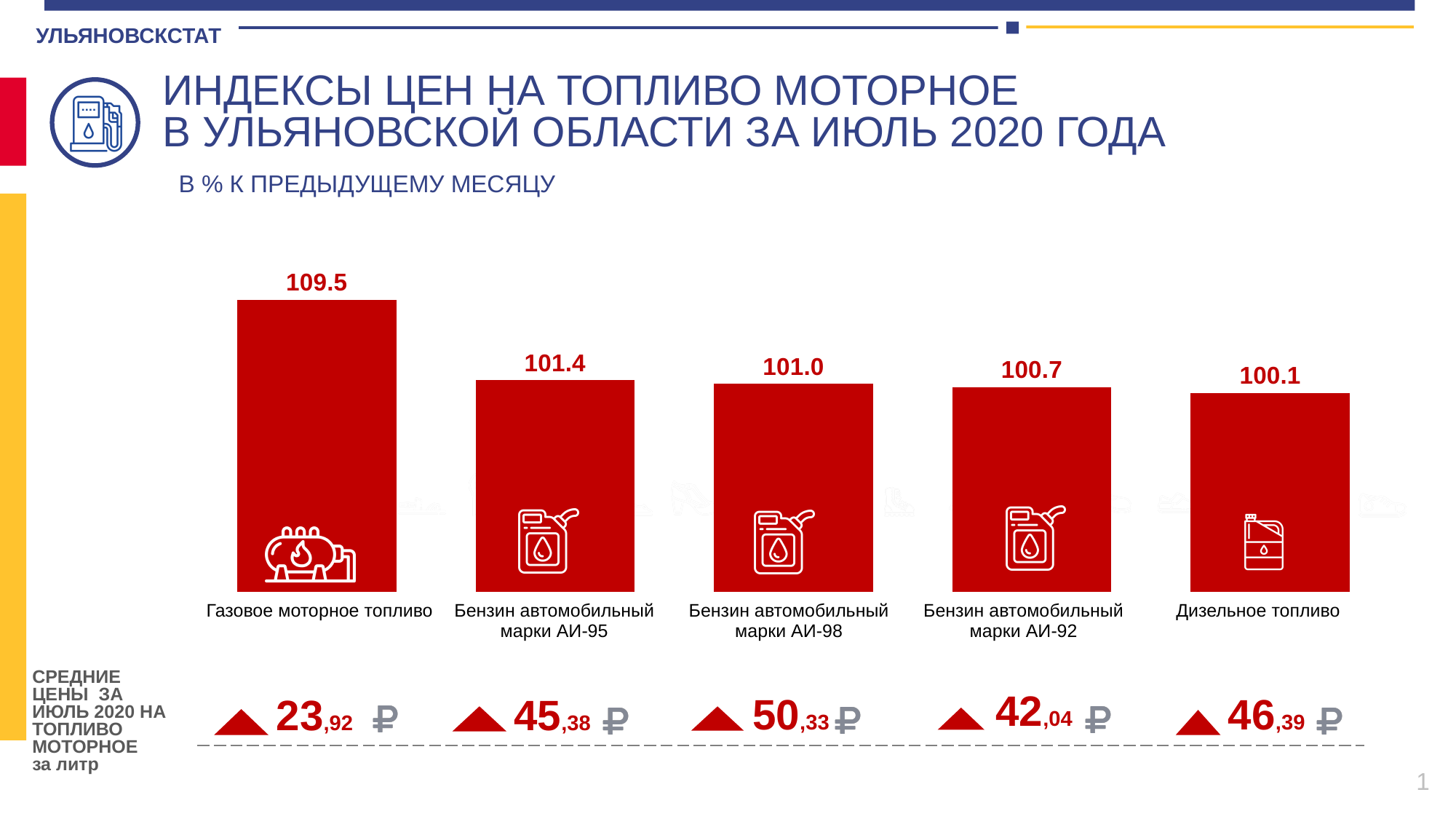
What is the difference between the price index for Бензин автомобильный марки АИ-95 and Бензин автомобильный марки АИ-92? 0.7 What is the price index value for Дизельное топливо? 100.1 What is the price index value for Бензин автомобильный марки АИ-98? 101.0 How many fuel categories are shown in the chart? 5 What is the difference between the price index for Газовое моторное топливо and Дизельное топливо? 9.4 What is the price index value for Бензин автомобильный марки АИ-95? 101.4 Which category has the lowest price index? Дизельное топливо What is the price index value for Бензин автомобильный марки АИ-92? 100.7 What is the price index value for Газовое моторное топливо? 109.5 What type of chart is shown on the slide? Bar chart Which category has the highest price index? Газовое моторное топливо Which has a higher price index, Бензин автомобильный марки АИ-98 or Дизельное топливо? Бензин автомобильный марки АИ-98